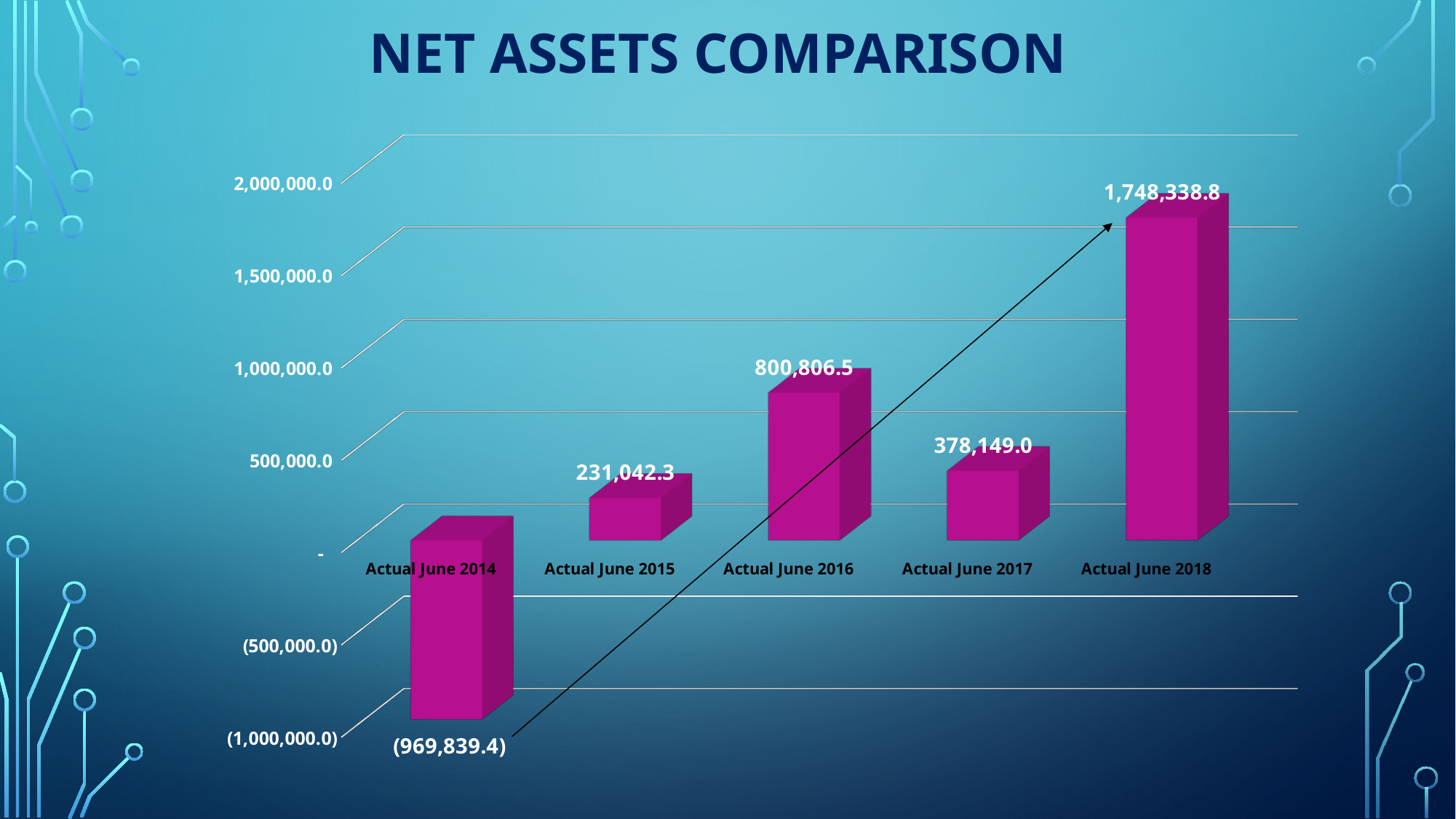
What is the value for Actual June 2015? 231,042.3 What is the value for Actual June 2016? 800,806.5 What is the value for Actual June 2014? (969,839.4) Which is larger, the value for Actual June 2015 or Actual June 2017? Actual June 2017 Which category has the highest value? Actual June 2018 Which category has the lowest value? Actual June 2014 What is the difference between the values for Actual June 2018 and Actual June 2016? 947,532.3 Is the value for Actual June 2018 greater or less than 1,500,000.0? greater How many categories are shown on the x axis? 5 What is the value for Actual June 2018? 1,748,338.8 What is the difference between the values for Actual June 2016 and Actual June 2017? 422,657.5 What kind of chart is shown on the slide? bar chart